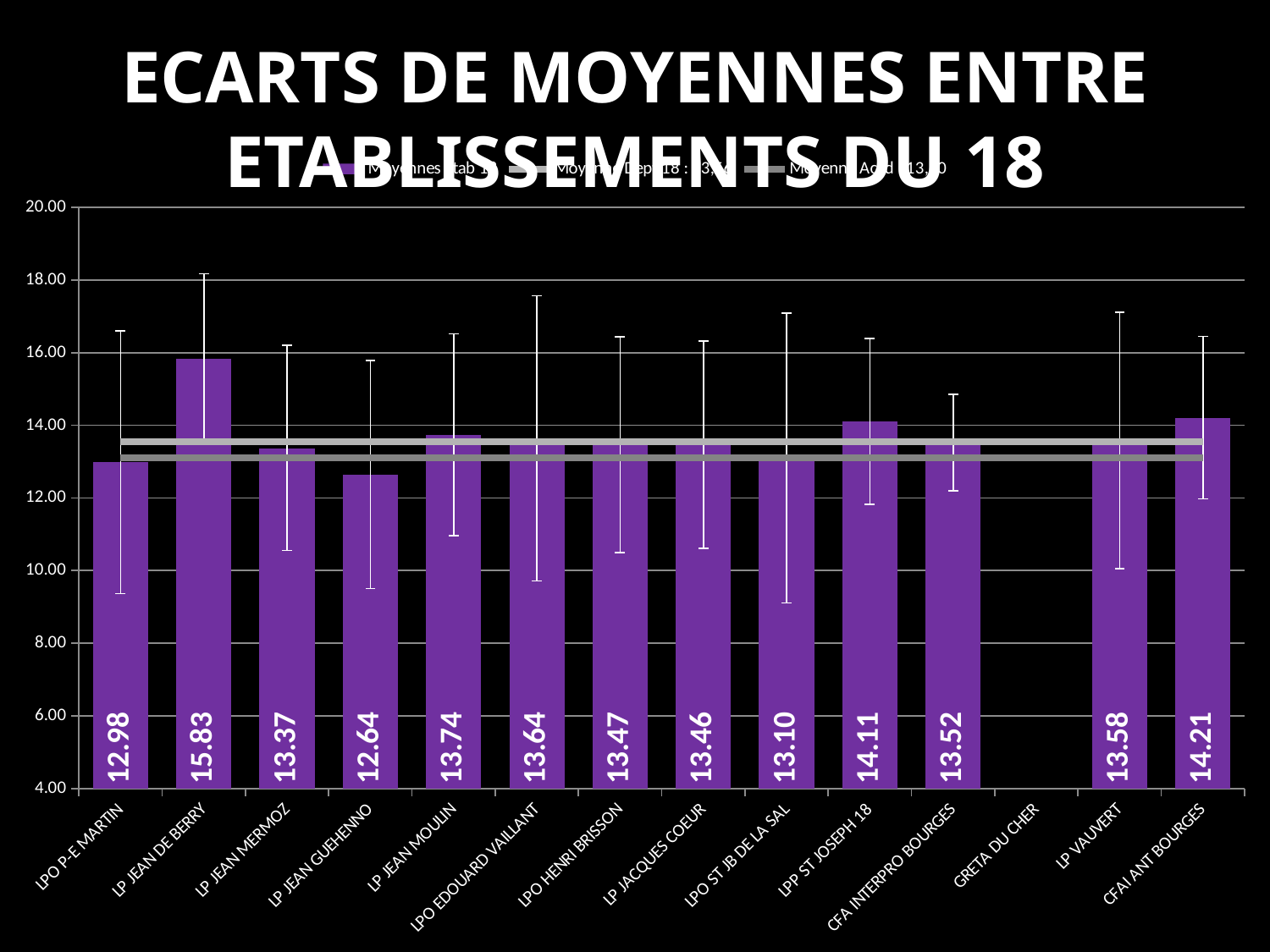
What is the difference between the values for LPO HENRI BRISSON and LP JACQUES COEUR? 0.01 What is the value shown for LP VAUVERT? 13.58 What is the value shown for CFA INTERPRO BOURGES? 13.52 Which establishment has the lowest plotted bar value? LP JEAN GUEHENNO What is the difference between the values for LP JEAN DE BERRY and LP JEAN GUEHENNO? 3.19 What is the value shown for LP JEAN DE BERRY? 15.83 What is the value shown for LPO ST JB DE LA SAL? 13.10 Which establishment has the highest bar? LP JEAN DE BERRY Is the value for LPO P-E MARTIN greater or less than 14.00? less What kind of chart is shown on the slide? combination bar and line chart Which has the larger value, LPP ST JOSEPH 18 or CFAI ANT BOURGES? CFAI ANT BOURGES How many establishments are listed along the x axis? 14